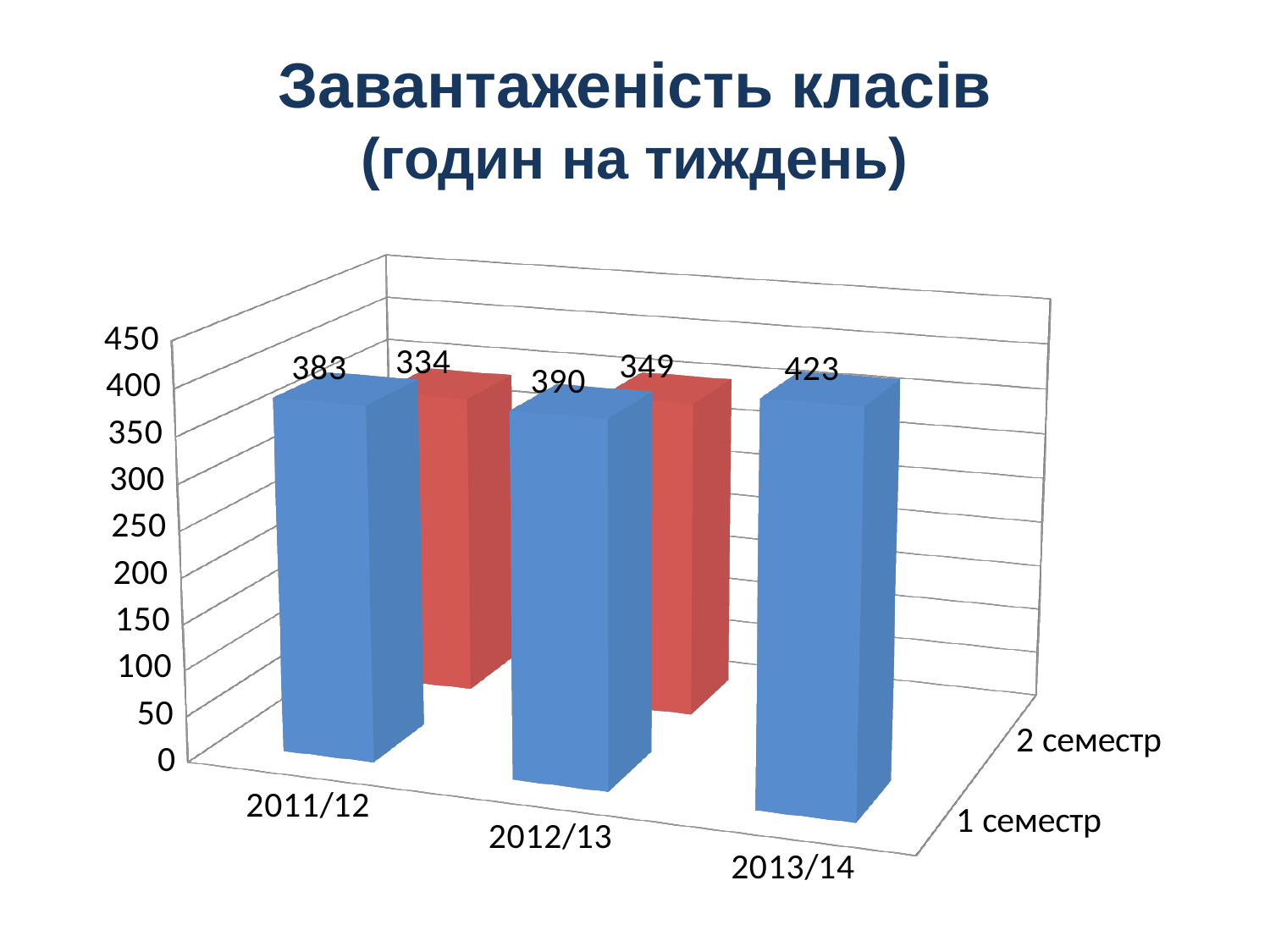
How many years are shown on the x axis? 3 Which year has the highest value for 1 семестр? 2013/14 Which year has the lowest value for 1 семестр? 2011/12 What is the value for 2 семестр in 2011/12? 334 What is the value for 1 семестр in 2013/14? 423 Do the 1 семестр values rise or fall from 2011/12 to 2013/14? rise What is the value for 1 семестр in 2011/12? 383 Which is larger in 2012/13: 1 семестр or 2 семестр? 1 семестр What is the difference between the 1 семестр and 2 семестр values in 2011/12? 49 What is the value for 2 семестр in 2012/13? 349 What is the difference between the 1 семестр values for 2013/14 and 2012/13? 33 What kind of chart is shown on the slide? bar chart